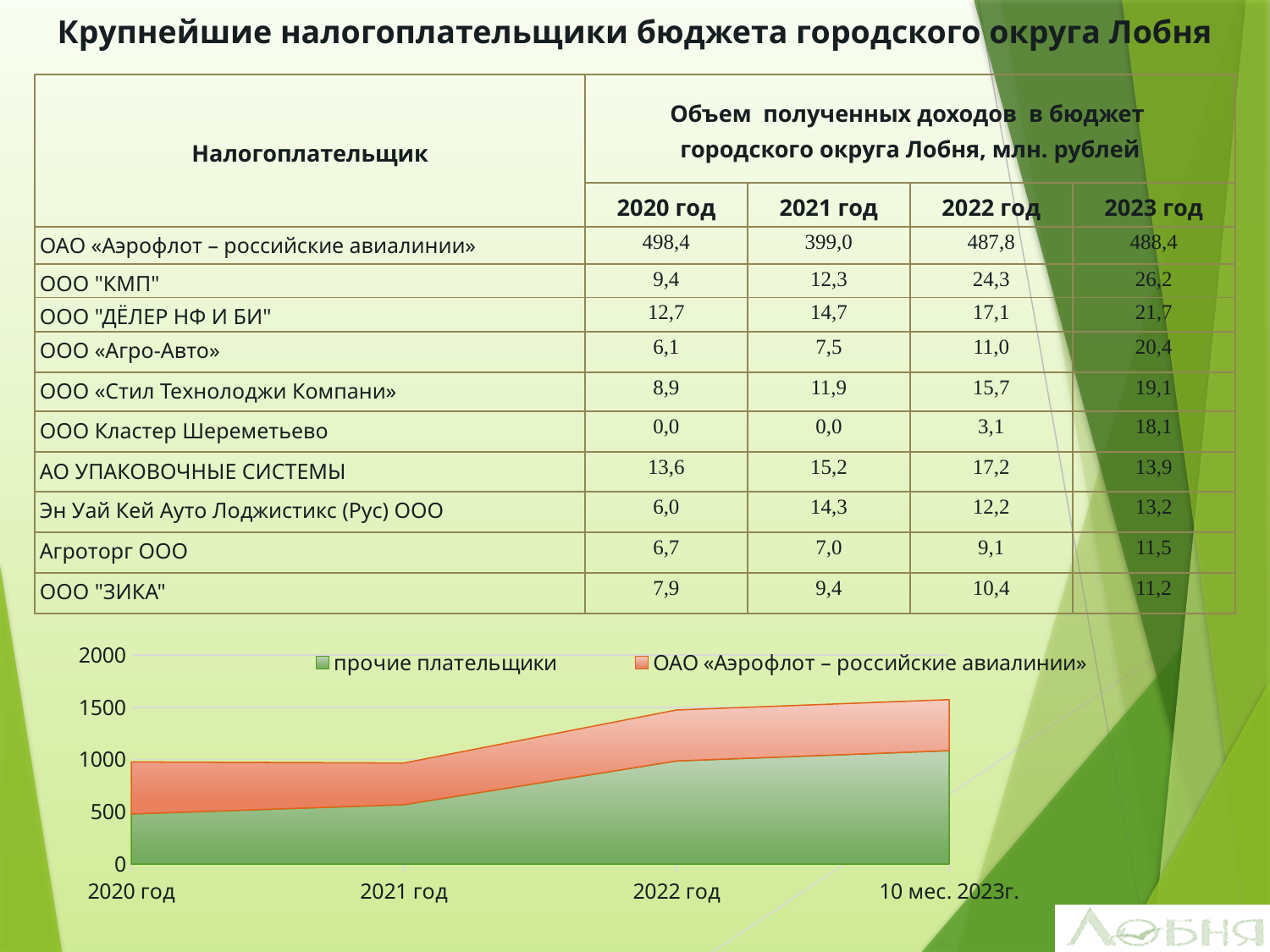
How many series does the legend of the area chart list? 2 In the area chart, does the value for прочие плательщики rise or fall from 2020 год to 10 мес. 2023г.? rise In the area chart, is the value for прочие плательщики in 2021 год greater or less than 500? greater In the area chart, is the combined total of both series in 2021 год greater or less than 1500? less What kind of chart is shown at the bottom of the slide? Stacked area chart In the area chart, is the combined total of both series in 10 мес. 2023г. greater or less than 1500? greater In the area chart, which period has the highest value for прочие плательщики? 10 мес. 2023г. Which series in the area chart is shown in green? прочие плательщики In the area chart, which period has the lowest value for прочие плательщики? 2020 год How many periods are shown along the x axis of the area chart? 4 Which series in the area chart is shown in orange? ОАО «Аэрофлот – российские авиалинии»